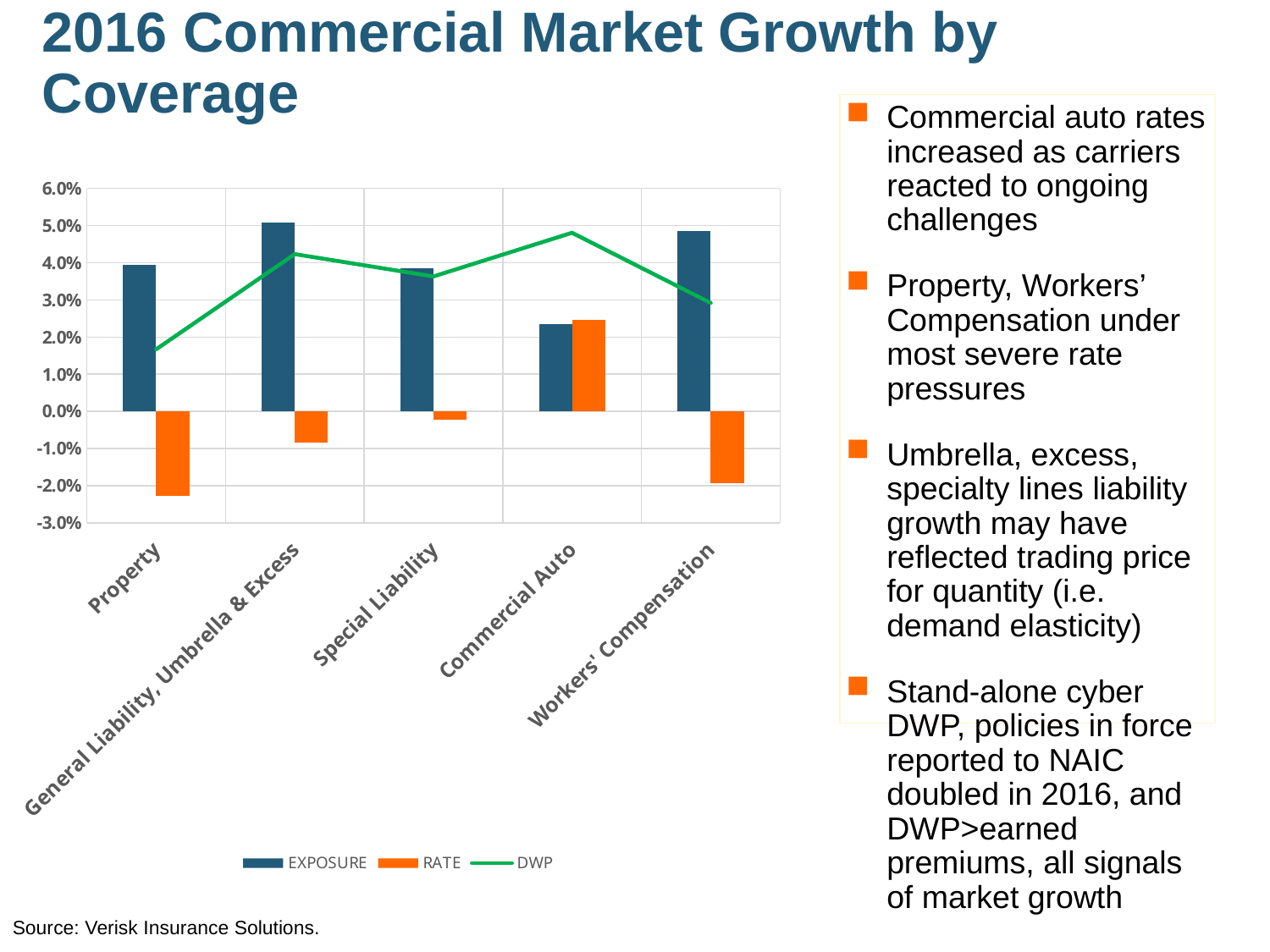
How many coverage categories are shown on the x axis? 5 Which coverage is the only one with a positive RATE value? Commercial Auto How many series does the legend list? 3 Which coverage has the lowest EXPOSURE bar? Commercial Auto Which series is plotted as a green line? DWP Which is larger, the DWP value for Property or the DWP value for General Liability, Umbrella & Excess? General Liability, Umbrella & Excess Which coverage has the highest EXPOSURE bar? General Liability, Umbrella & Excess Which coverage has the highest DWP value? Commercial Auto Which coverage has the lowest RATE value? Property Is the RATE value for Property greater or less than -2.0%? less What kind of chart is shown on the slide? A combined bar and line chart